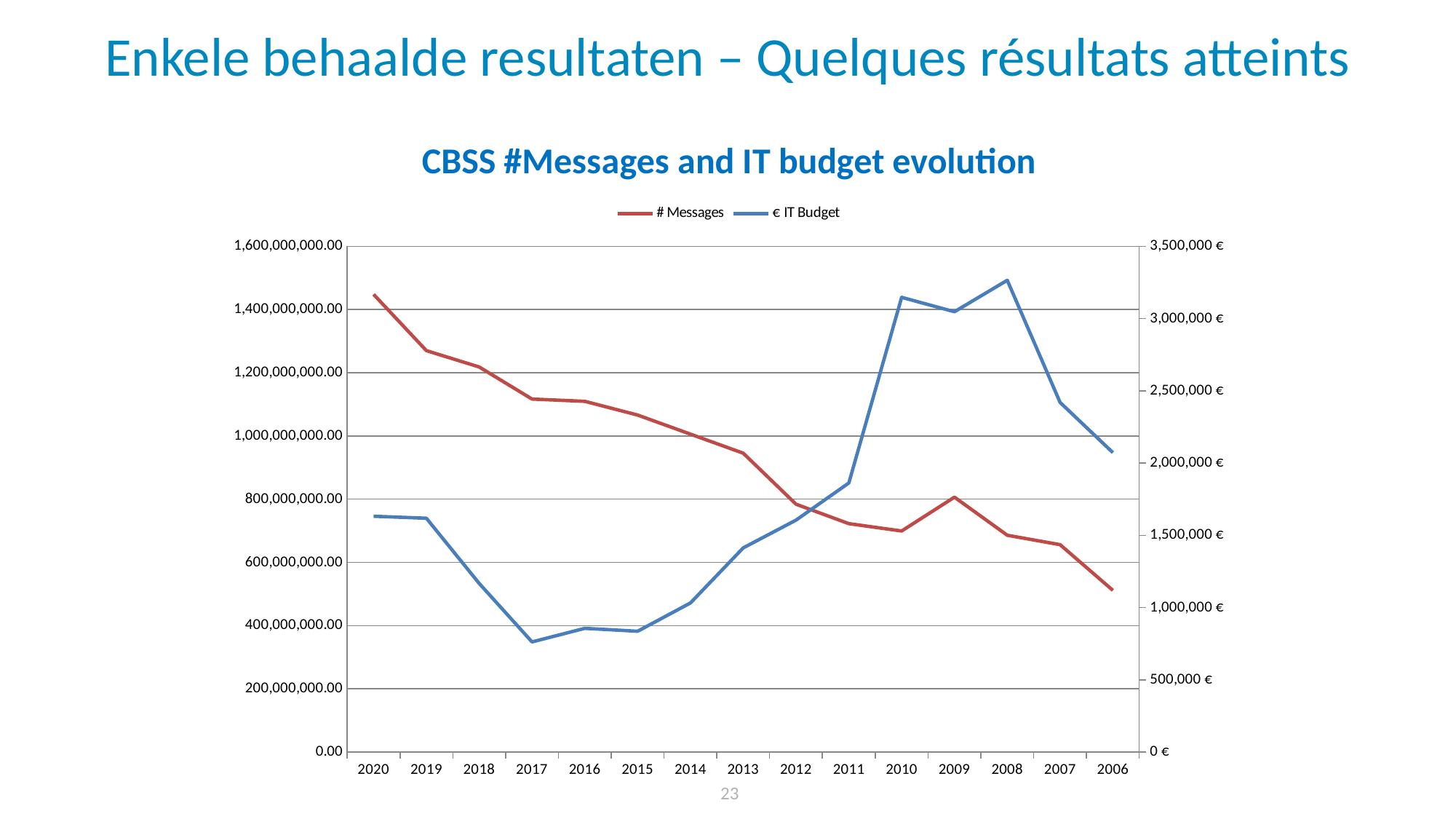
How many series does the legend list? 2 Which year has the higher # Messages value, 2009 or 2010? 2009 Is the # Messages value for 2020 greater or less than 1,200,000,000.00? greater How many years are shown on the x axis? 15 In which year is the € IT Budget series at its highest? 2008 Is the € IT Budget value for 2017 greater or less than 1,000,000 €? less In which year is the # Messages series at its highest? 2020 What kind of chart is shown on the slide? line chart What is the title of the chart? CBSS #Messages and IT budget evolution Is the # Messages value for 2006 greater or less than 600,000,000.00? less In which year is the # Messages series at its lowest? 2006 In which year is the € IT Budget series at its lowest? 2017